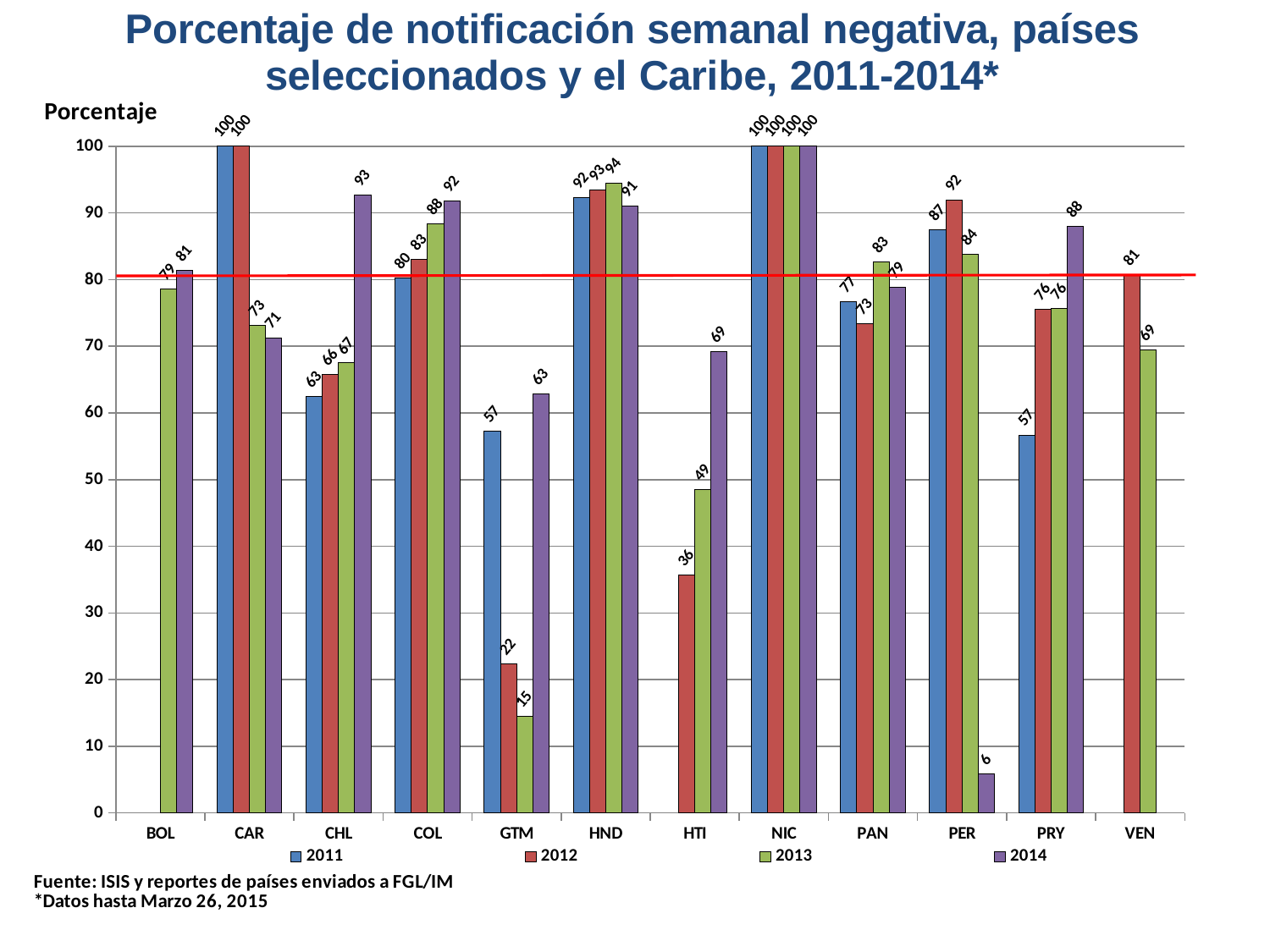
Which is larger, the 2012 value for PER or the 2012 value for PAN? PER (92) What is the value for HTI in 2012? 36 How many series does the legend list? 4 What is the value for PER in 2014? 6 What is the difference between the 2014 and 2013 values for HTI? 20 How many countries/categories are shown on the x axis? 12 What is the source cited below the chart? ISIS y reportes de países enviados a FGL/IM What type of chart is shown on the slide? bar chart Which year has the highest value for CHL? 2014 Which country has the lowest value in 2014? PER Do the values for COL rise or fall from 2011 to 2014? rise What is the value for GTM in 2013? 15